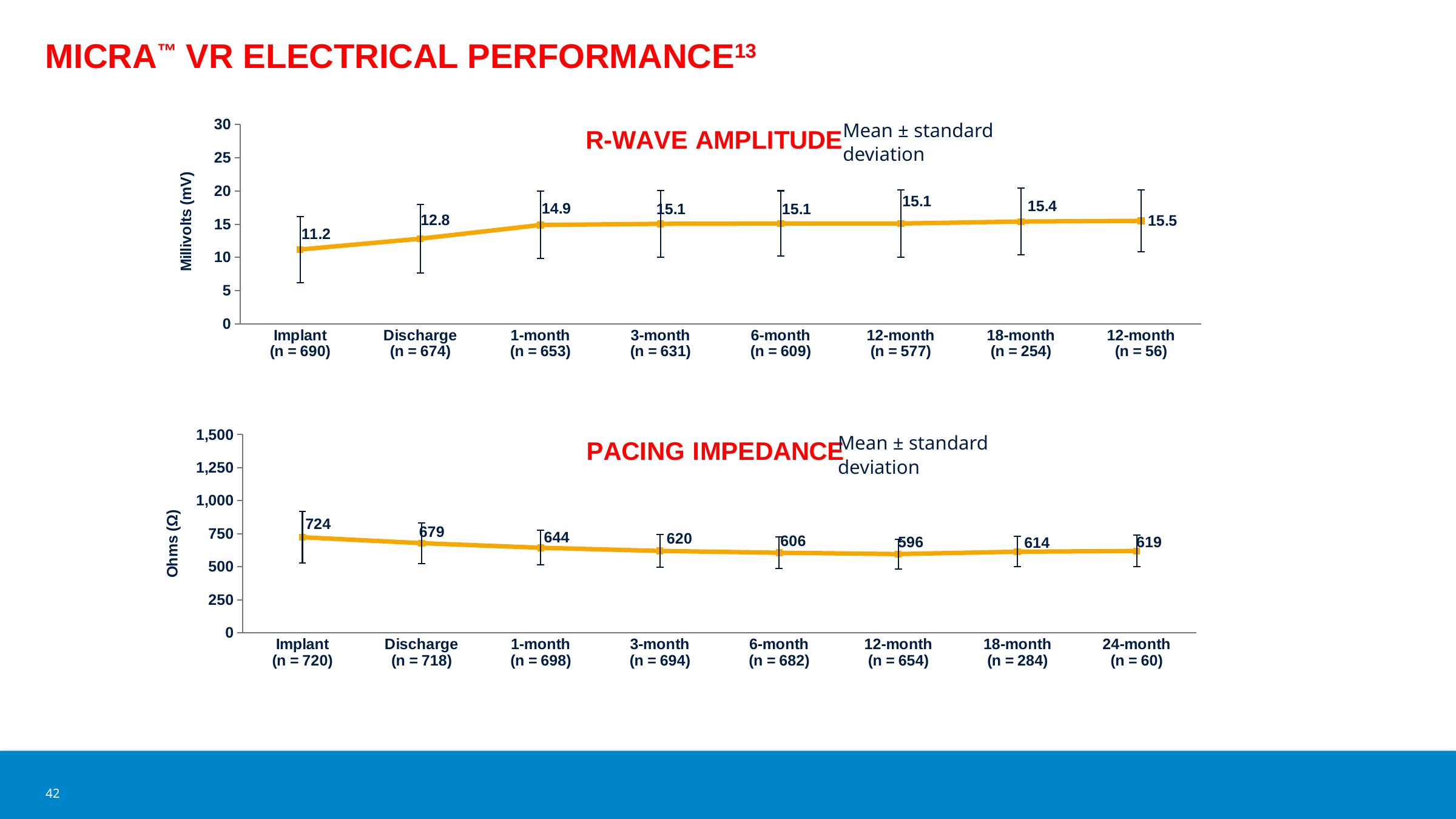
On the Pacing Impedance chart, which time point has the highest value? Implant On the Pacing Impedance chart, which is larger, the 18-month value or the 24-month value? 24-month On the R-Wave Amplitude chart, what is the value at Implant? 11.2 How many time points are plotted on the R-Wave Amplitude chart? 8 What kind of chart is the R-Wave Amplitude chart? Line chart On the Pacing Impedance chart, do the values rise or fall from Implant to 12-month? Fall On the R-Wave Amplitude chart, what is the value at 18-month? 15.4 On the Pacing Impedance chart, what is the difference between the Implant value and the Discharge value? 45 On the R-Wave Amplitude chart, what is the difference between the 1-month value and the Implant value? 3.7 On the R-Wave Amplitude chart, which time point has the lowest value? Implant On the Pacing Impedance chart, what is the value at Implant? 724 On the Pacing Impedance chart, which time point has the lowest value? 12-month